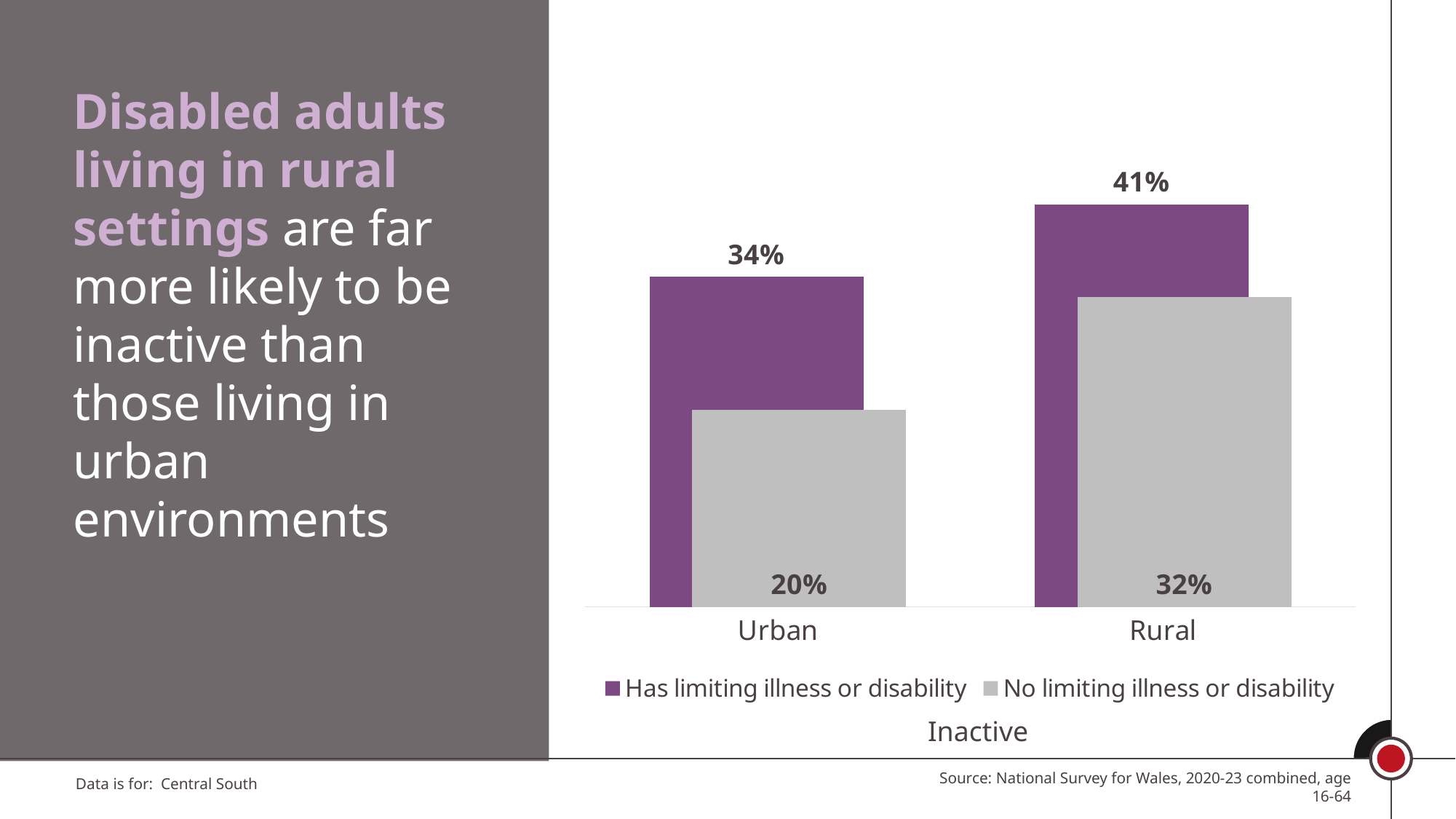
What is the value for Urban in the 'Has limiting illness or disability' series? 34% Which category has the lowest value in the 'No limiting illness or disability' series? Urban What is the value for Rural in the 'Has limiting illness or disability' series? 41% How many categories are shown on the x axis? 2 What kind of chart is shown on the slide? Bar chart How many series does the legend list? 2 Which category has the highest value in the 'Has limiting illness or disability' series? Rural What is the difference between the 'Has limiting illness or disability' and 'No limiting illness or disability' values for Rural? 9% What is the difference between the Rural and Urban values in the 'Has limiting illness or disability' series? 7% What is the value for Urban in the 'No limiting illness or disability' series? 20% Which is larger for Urban: 'Has limiting illness or disability' or 'No limiting illness or disability'? Has limiting illness or disability What is the value for Rural in the 'No limiting illness or disability' series? 32%